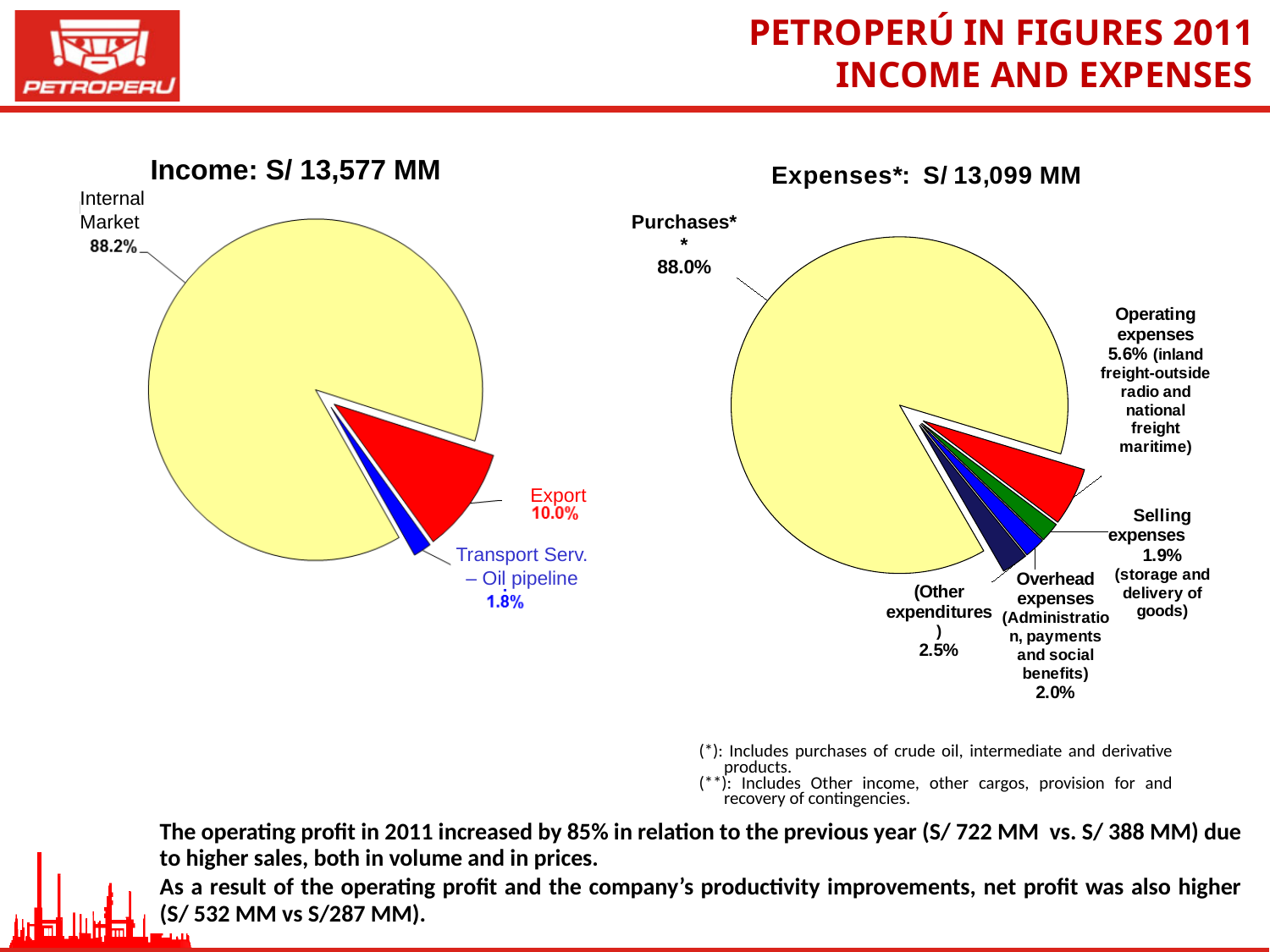
In the Expenses pie chart, how many categories are shown? 5 In the Income pie chart, what is the difference in percentage points between Export and Transport Serv. – Oil pipeline? 8.2 In the Expenses pie chart, what share do Purchases account for? 88.0% In the Income pie chart, what is the share for Transport Serv. – Oil pipeline? 1.8% In the Income pie chart, how many slices are there? 3 In the Income pie chart, which category has the smallest share? Transport Serv. – Oil pipeline In the Income pie chart, what percentage of income comes from Export? 10.0% In the Expenses pie chart, what is the share of Operating expenses? 5.6% In the Expenses pie chart, which category has the largest share? Purchases What type of chart is used for the Expenses data? Pie chart In the Expenses pie chart, which is larger: Other expenditures or Overhead expenses? Other expenditures In the Income pie chart, what share does the Internal Market account for? 88.2%